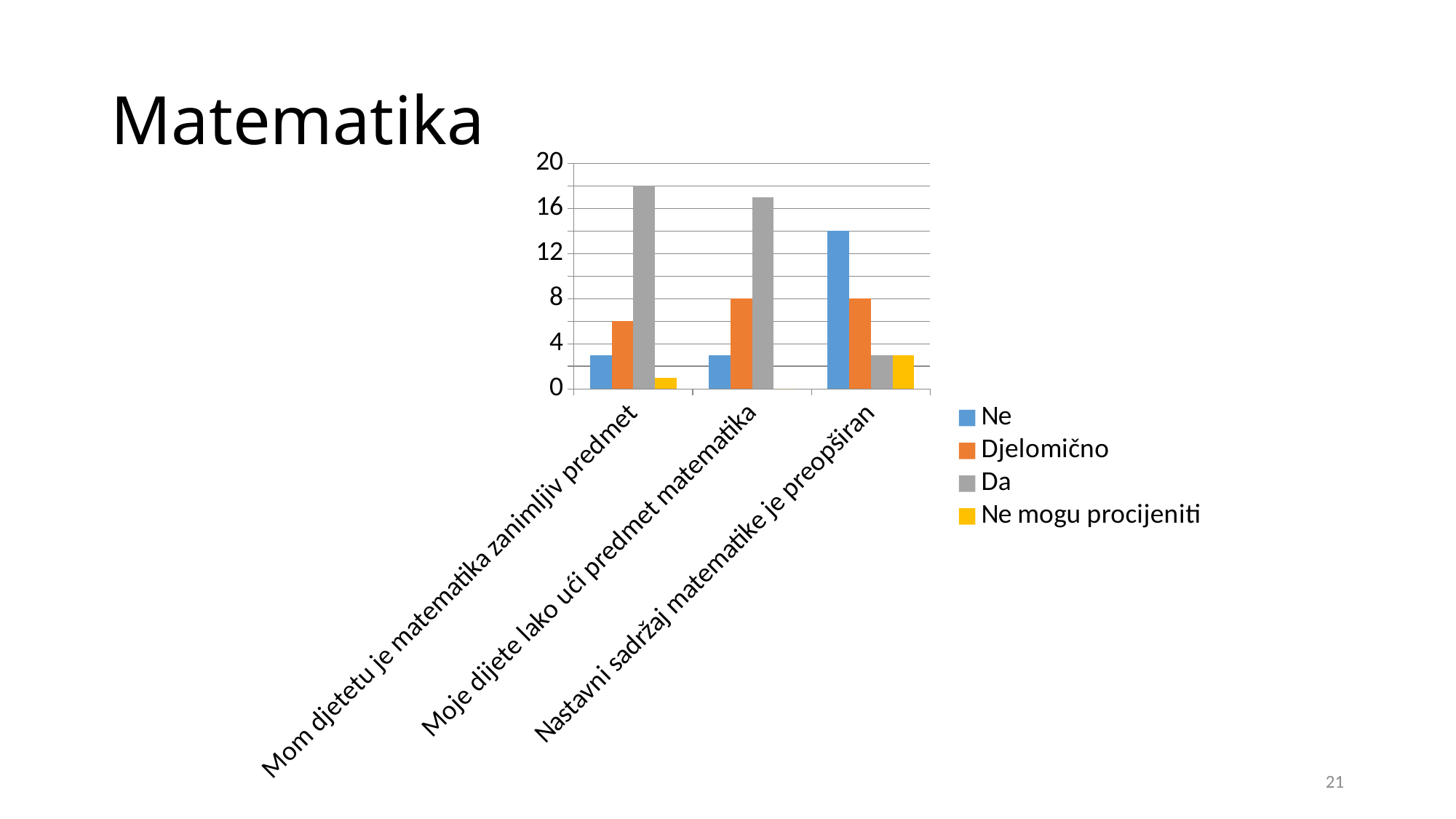
What is the title of the slide containing the chart? Matematika Is the value of "Ne" for "Nastavni sadržaj matematike je preopširan" greater or less than 12? greater Which series has the lowest value for "Mom djetetu je matematika zanimljiv predmet"? Ne mogu procijeniti How many categories are shown on the x axis? 3 Which series has the highest value for "Mom djetetu je matematika zanimljiv predmet"? Da Is the value of "Ne" for "Mom djetetu je matematika zanimljiv predmet" greater or less than 4? less What kind of chart is shown on the slide? bar chart How many series does the legend list? 4 What is the value of "Djelomično" for "Nastavni sadržaj matematike je preopširan"? 8 Is the value of "Da" for "Mom djetetu je matematika zanimljiv predmet" greater or less than 16? greater Which is larger: the "Ne" value for "Nastavni sadržaj matematike je preopširan" or the "Ne" value for "Mom djetetu je matematika zanimljiv predmet"? Nastavni sadržaj matematike je preopširan What is the value of "Djelomično" for "Moje dijete lako uči predmet matematika"? 8